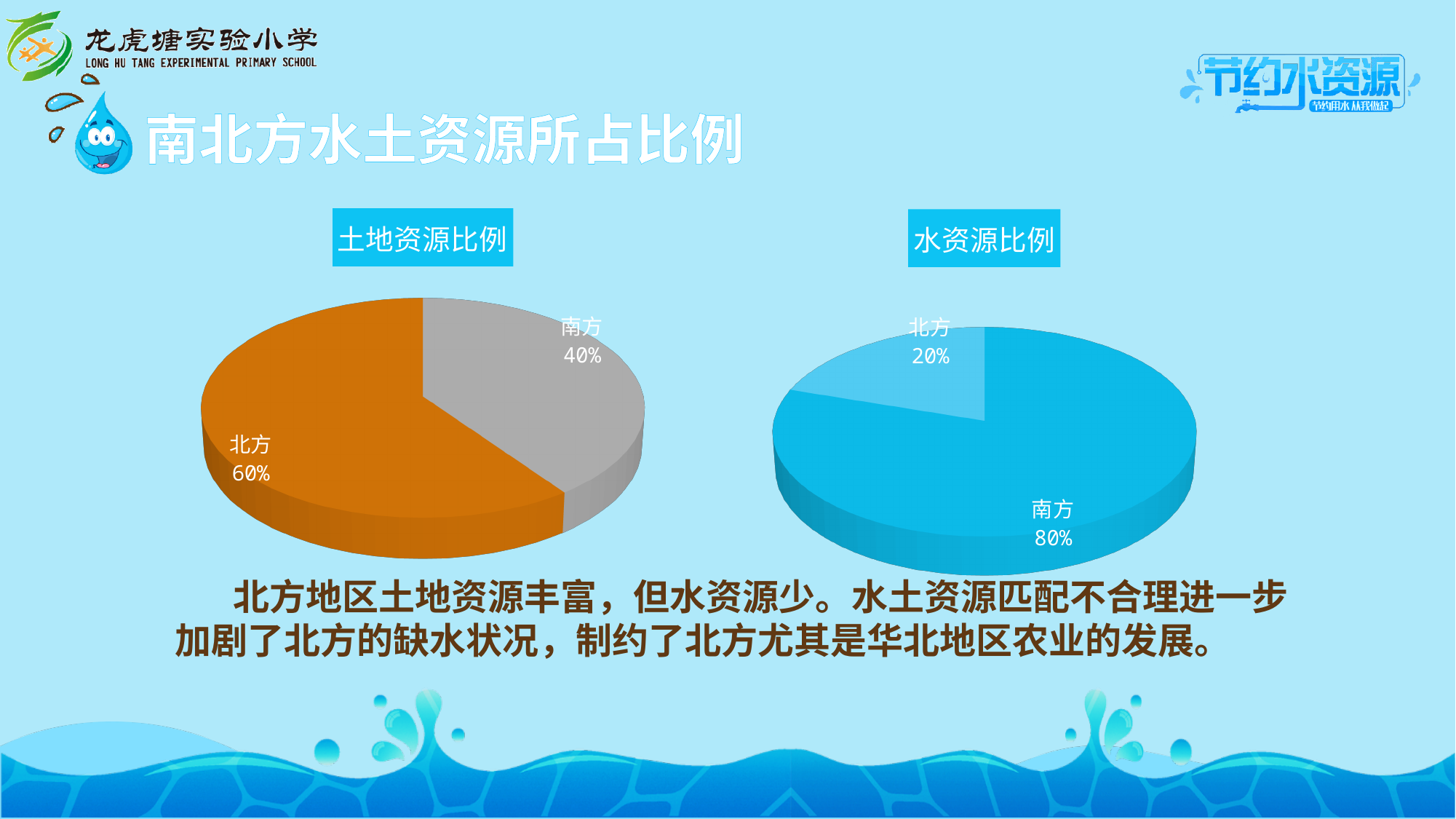
In the 土地资源比例 chart, what share does 南方 have? 40% In the 水资源比例 chart, what is the difference between the 南方 and 北方 shares? 60% In the 土地资源比例 chart, what is the difference between the 北方 and 南方 shares? 20% In the 水资源比例 chart, what share does 南方 have? 80% In the 水资源比例 chart, what share does 北方 have? 20% In the 水资源比例 chart, which region has the smaller slice? 北方 In the 土地资源比例 chart, which region has the larger slice? 北方 How many slices does the 土地资源比例 chart have? 2 Is the 北方 share larger in the 土地资源比例 chart or in the 水资源比例 chart? 土地资源比例 In the 土地资源比例 chart, what share does 北方 have? 60% What kind of chart is the 水资源比例 chart? Pie chart What colour is the 北方 slice in the 土地资源比例 chart? Orange